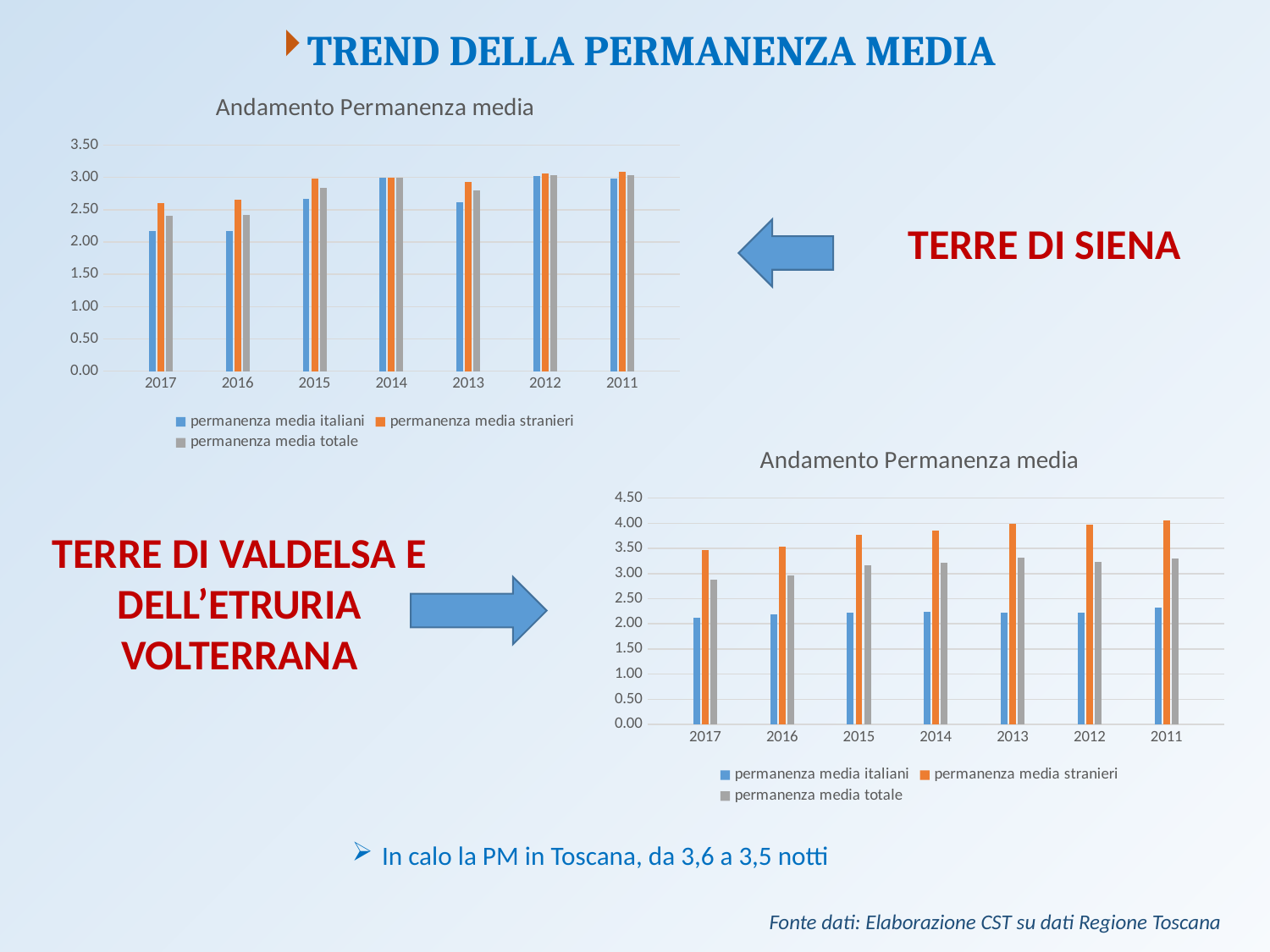
In the bottom-right chart, is the value for 'permanenza media italiani' in 2017 greater or less than 2.50? less In the top-left chart, is the value for 'permanenza media stranieri' in 2017 greater or less than 2.50? greater In the bottom-right chart, is the value for 'permanenza media totale' in 2017 greater or less than 3.00? less What kind of chart is the top-left chart titled 'Andamento Permanenza media'? bar chart How many years are shown on the x axis of the top-left chart? 7 In the bottom-right chart, moving left to right along the x axis from 2017 to 2011, do the 'permanenza media stranieri' values generally rise or fall? rise In the top-left chart, which is larger in 2017: 'permanenza media italiani' or 'permanenza media stranieri'? permanenza media stranieri What is the title of the bottom-right chart? Andamento Permanenza media In the bottom-right chart, which series has the highest value in 2017? permanenza media stranieri How many series does the legend of the top-left chart list? 3